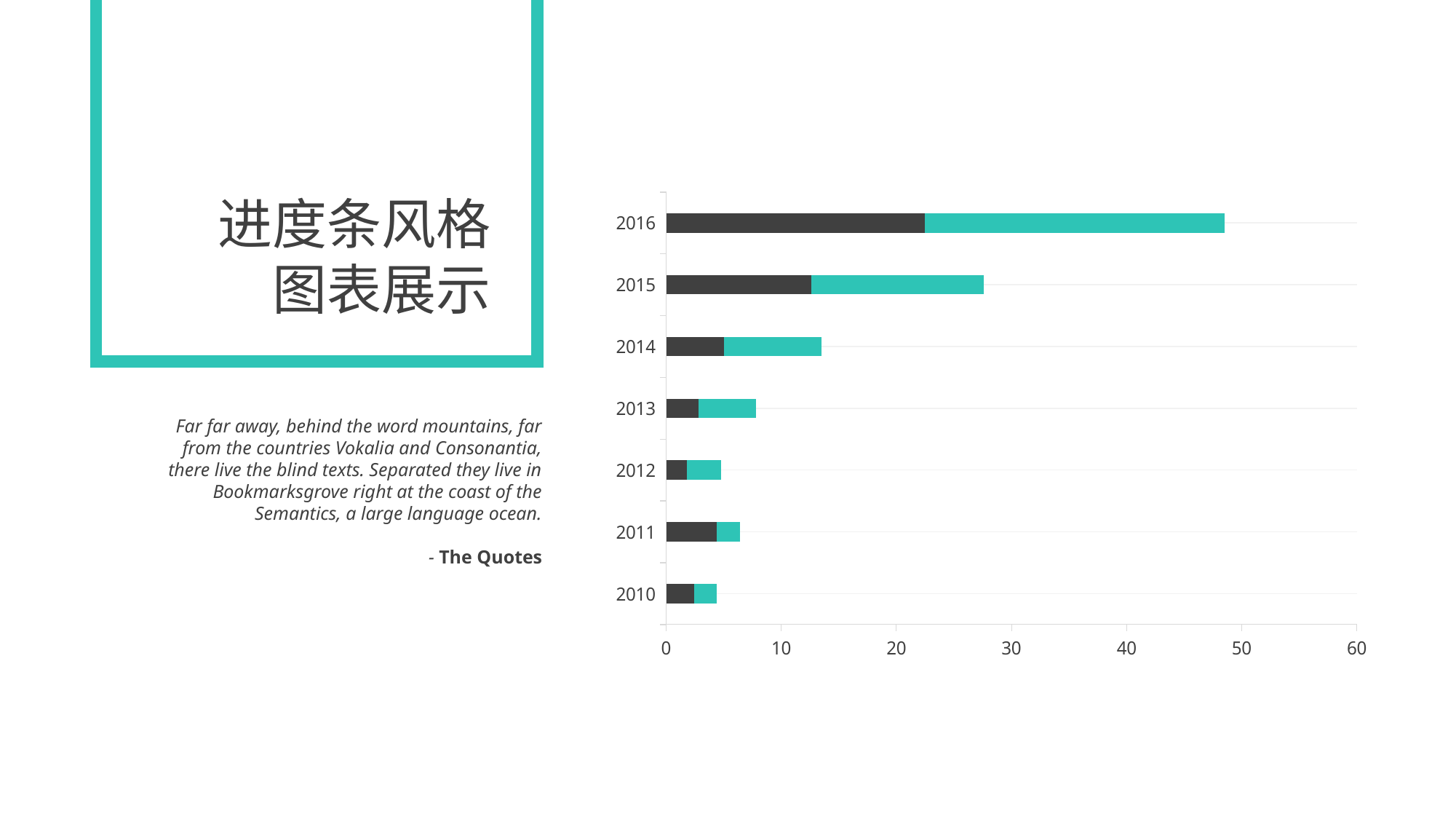
What kind of chart is shown on the slide? Stacked bar chart Which year has the longer total bar, 2015 or 2014? 2015 Is the total bar length for 2016 greater or less than 40? greater Is the total bar length for 2015 greater or less than 30? less Which year has the longest bar in the chart? 2016 Is the dark grey segment for 2016 greater or less than 20? greater How many years are shown on the chart's vertical axis? 7 Which year has the longer total bar, 2011 or 2012? 2011 What is the highest value shown on the chart's horizontal axis? 60